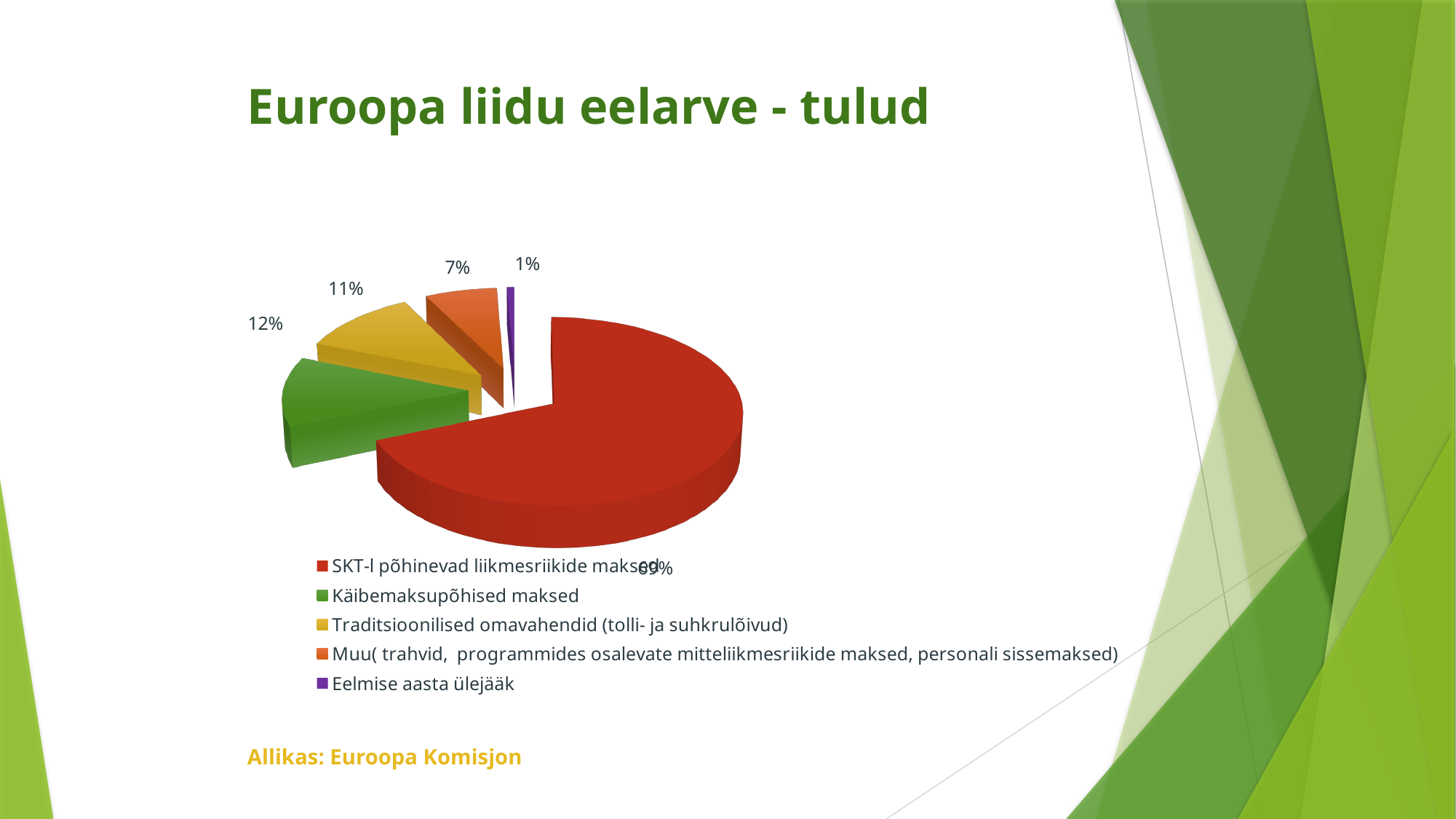
What share of the pie does "Traditsioonilised omavahendid (tolli- ja suhkrulõivud)" have? 11% What is the value shown for the "Muu" slice? 7% How many slices does the pie chart have? 5 Which is larger: the share for "Käibemaksupõhised maksed" or the share for "Traditsioonilised omavahendid (tolli- ja suhkrulõivud)"? Käibemaksupõhised maksed What share of the pie does "Eelmise aasta ülejääk" have? 1% What share of the pie does "SKT-l põhinevad liikmesriikide maksed" have? 69% What kind of chart is shown on the slide? Pie chart What is the difference in percentage points between "SKT-l põhinevad liikmesriikide maksed" and "Käibemaksupõhised maksed"? 57 Which category has the largest slice of the pie? SKT-l põhinevad liikmesriikide maksed What colour is the slice for "Eelmise aasta ülejääk"? Purple Which category has the smallest slice of the pie? Eelmise aasta ülejääk